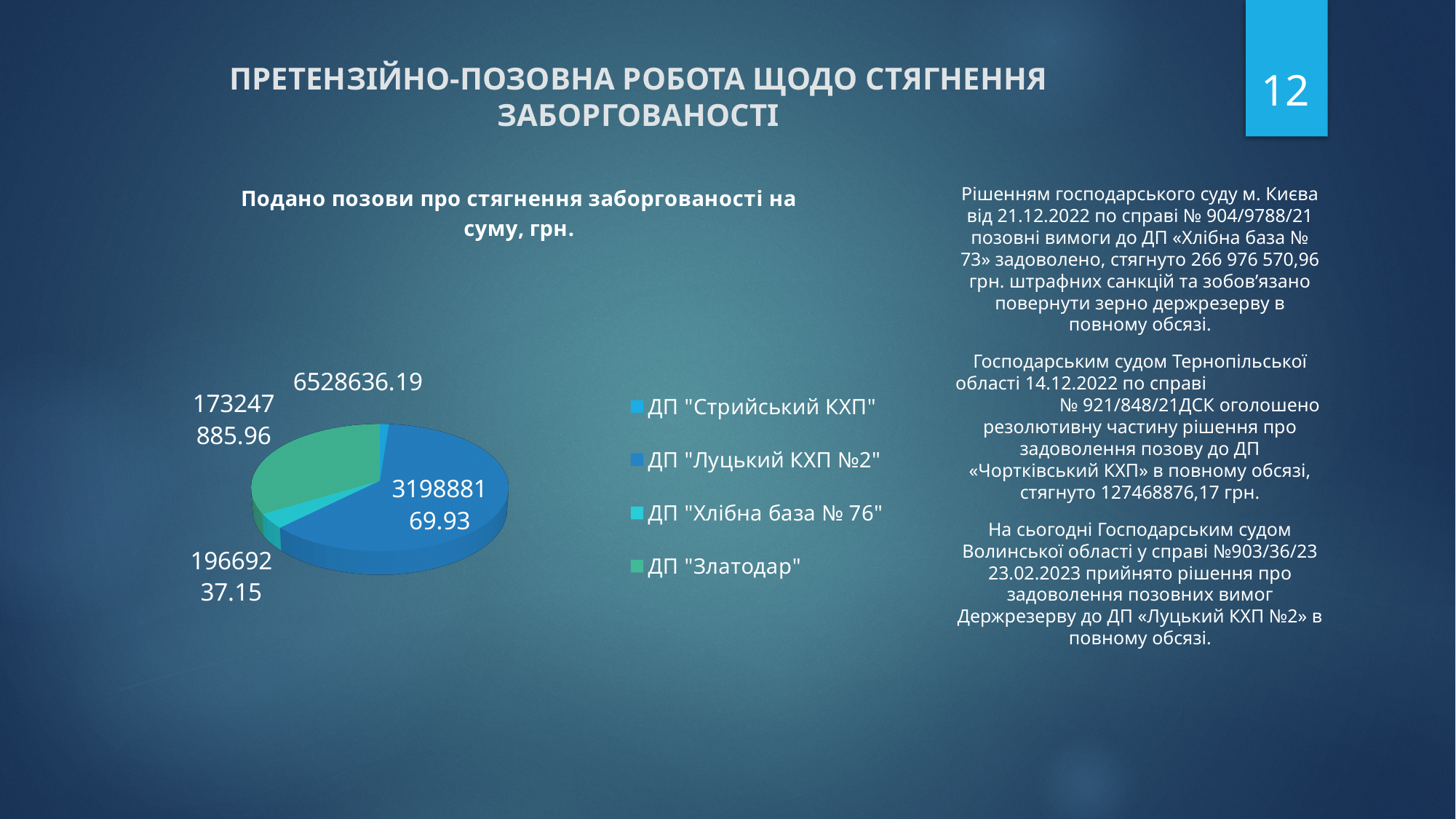
How many entries does the legend of the pie chart list? 4 What is the title of the pie chart? Подано позови про стягнення заборгованості на суму, грн. What is the smallest value printed on the pie chart? 6528636.19 What kind of chart is shown on the slide? Pie chart What is the value shown for ДП "Златодар" in the pie chart? 173247885.96 Which is larger in the pie chart: the value for ДП "Луцький КХП №2" or the value for ДП "Златодар"? ДП "Луцький КХП №2" How many slices does the pie chart have? 4 Which enterprise has the largest slice in the pie chart? ДП "Луцький КХП №2" What is the value shown for ДП "Луцький КХП №2" in the pie chart? 319888169.93 What is the difference between the values for ДП "Луцький КХП №2" and ДП "Златодар" in the pie chart? 146640283.97 Which enterprise has the smallest slice in the pie chart? ДП "Стрийський КХП" What colour is the slice for ДП "Златодар" in the pie chart? Green